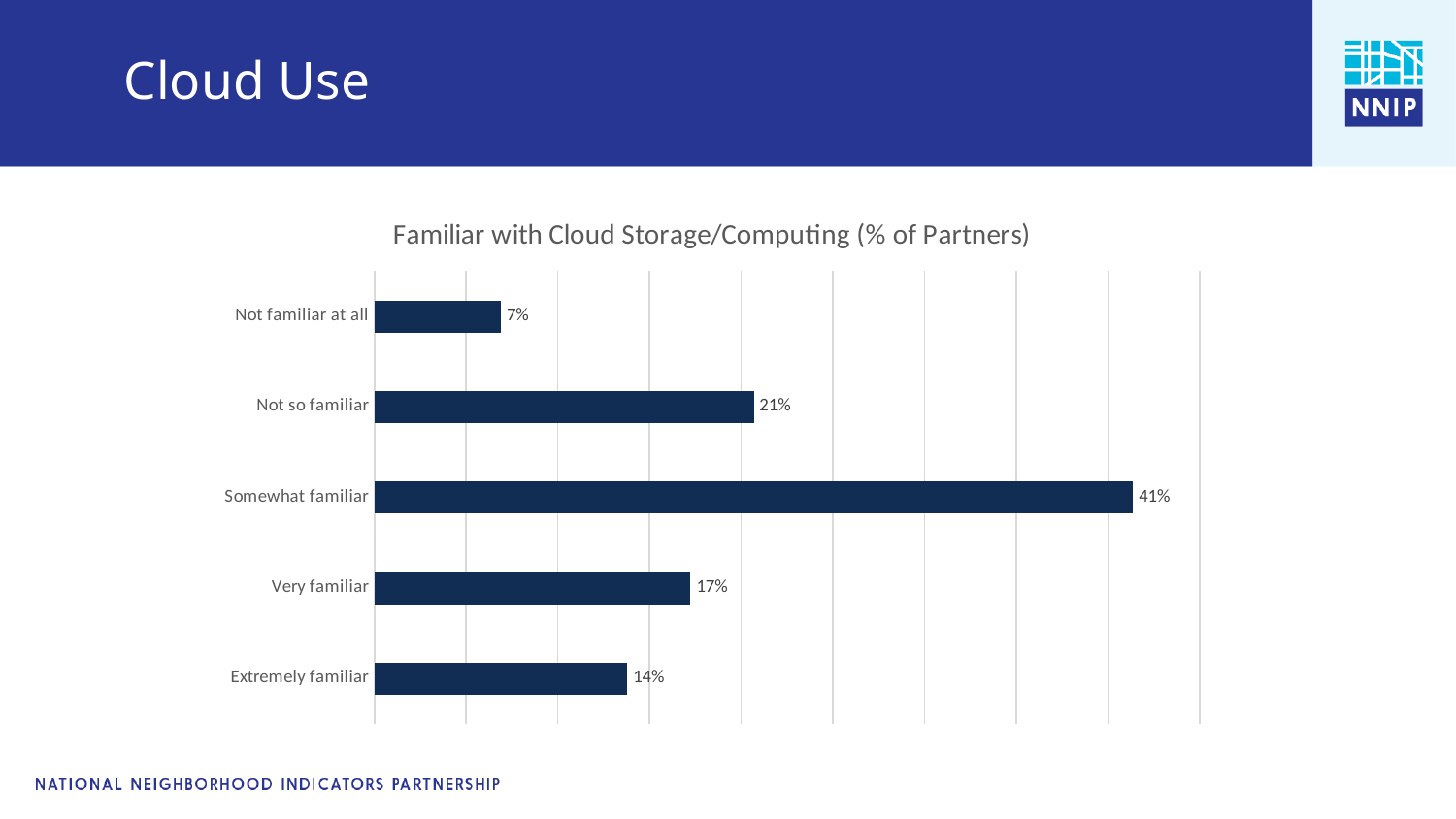
Which is larger, the value for Very familiar or the value for Extremely familiar? Very familiar What is the difference between the values for Not so familiar and Not familiar at all? 14% Which category has the lowest value? Not familiar at all What is the value for Very familiar? 17% Which category has the highest value? Somewhat familiar What is the value for Not familiar at all? 7% What is the difference between the values for Somewhat familiar and Not so familiar? 20% What percentage of partners are Somewhat familiar with cloud storage/computing? 41% What is the value for Extremely familiar? 14% What kind of chart is shown on the slide? Bar chart What is the title of the chart? Familiar with Cloud Storage/Computing (% of Partners) How many categories are shown in the chart? 5